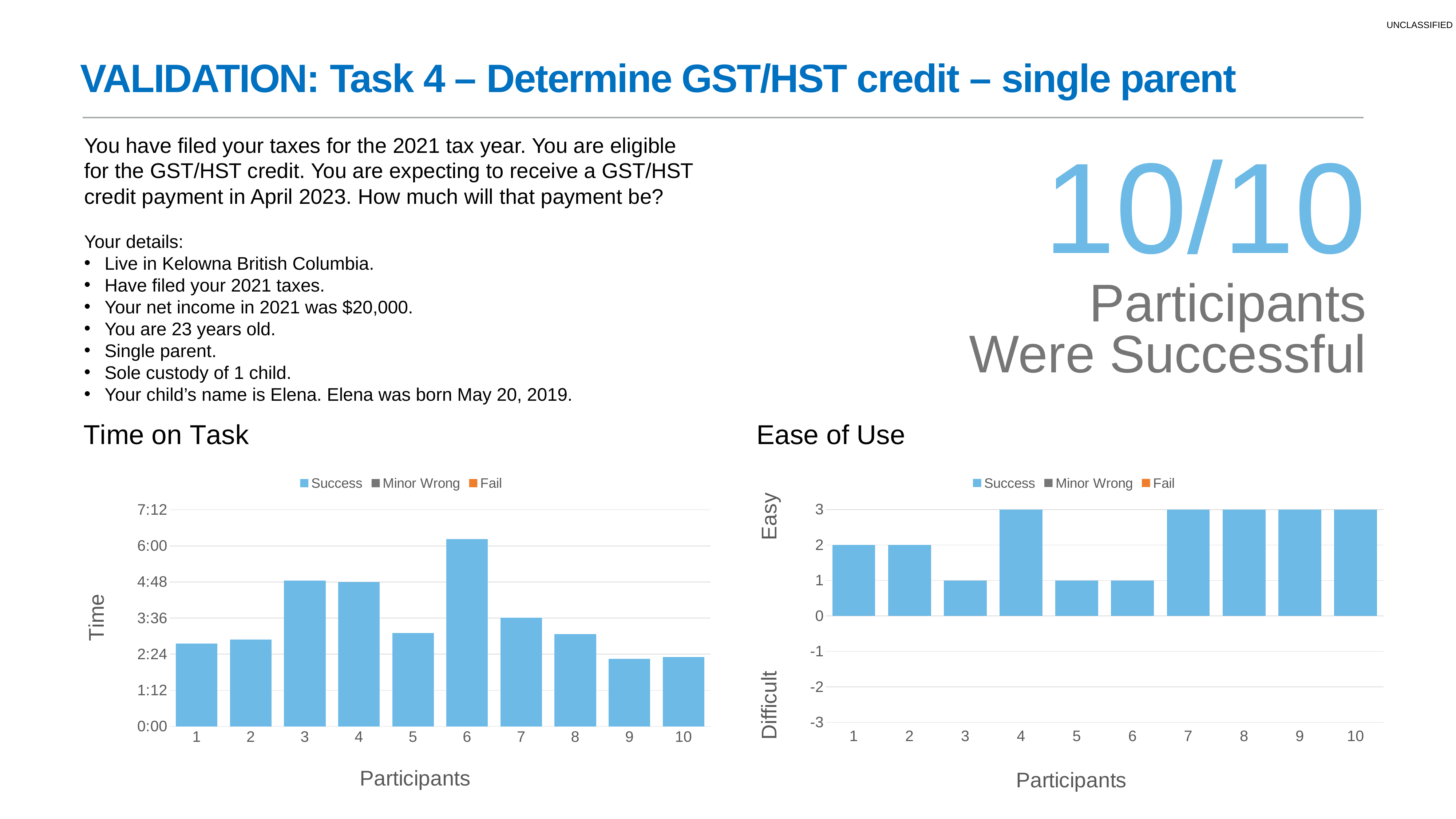
In the Ease of Use chart, how many participants have a value of 3? 5 In the Time on Task chart, which participant has the highest time? 6 What are the three legend entries in the Time on Task chart? Success, Minor Wrong, Fail In the Time on Task chart, is the value for participant 6 greater or less than 6:00? greater In the Time on Task chart, is the value for participant 1 greater or less than 3:36? less What kind of chart is the Time on Task chart? bar chart How many series does the legend of the Ease of Use chart list? 3 In the Time on Task chart, which is larger, the value for participant 3 or participant 8? participant 3 How many participants are shown on the x axis of the Time on Task chart? 10 In the Ease of Use chart, what is the value for participant 4? 3 In the Ease of Use chart, what is the value for participant 1? 2 In the Ease of Use chart, what is the difference between the values for participant 4 and participant 3? 2